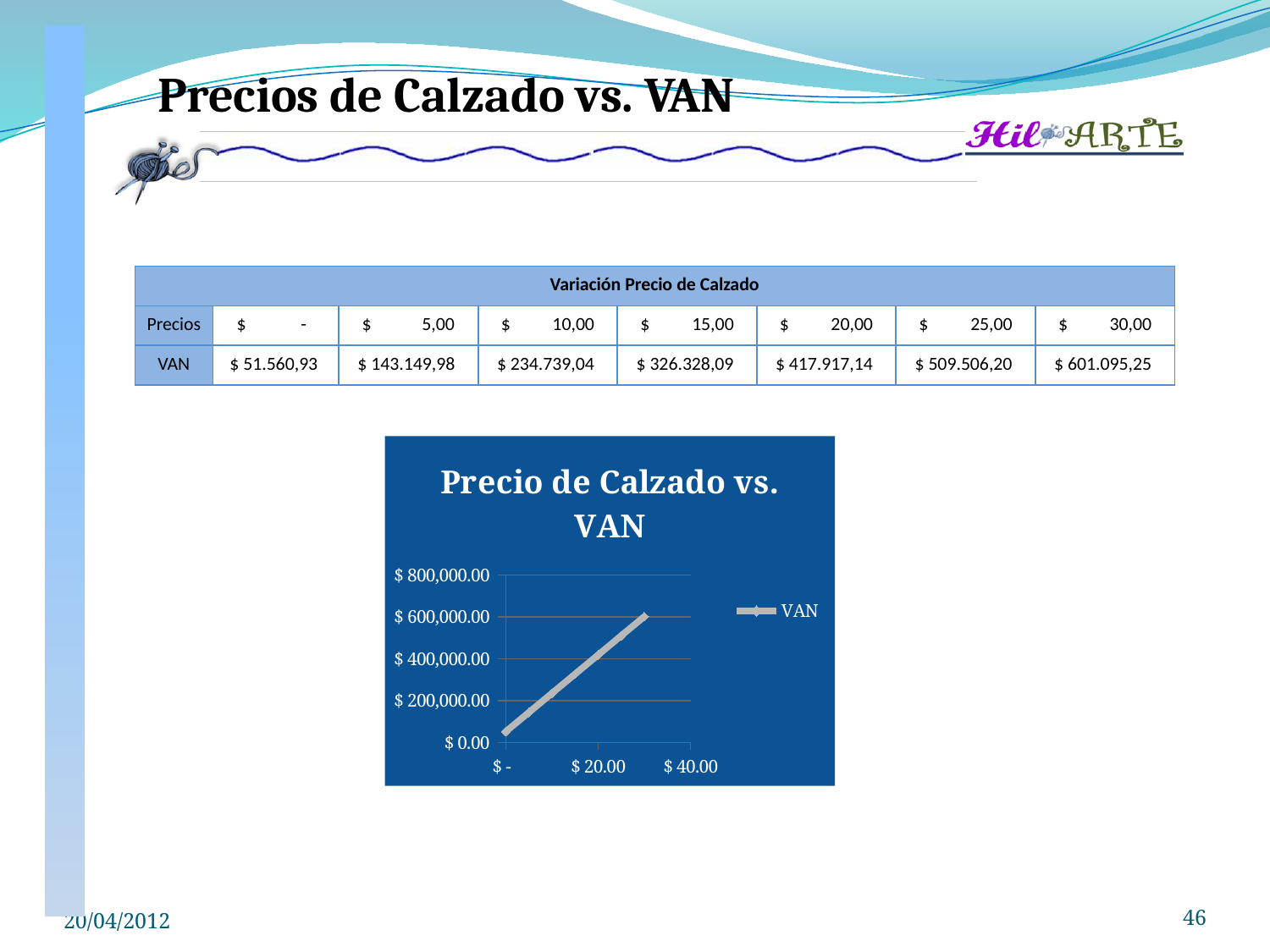
According to the table, which price gives the lowest VAN? $ - Is the VAN value at a price of $30.00 greater or less than $400,000.00? greater How many price points are listed in the table plotted in the chart? 7 How many series does the chart legend list? 1 Does the VAN value rise or fall as the price increases along the x axis? rise What kind of chart is shown on the slide? line chart What is the title of the chart? Precio de Calzado vs. VAN Is the VAN value at a price of $0 greater or less than $200,000.00? less According to the table, what is the VAN when the price is $ 30,00? $ 601.095,25 According to the table, what is the VAN when the price is $ 15,00? $ 326.328,09 What is the name of the series shown in the chart legend? VAN What is the highest value shown on the chart's y axis? $ 800,000.00